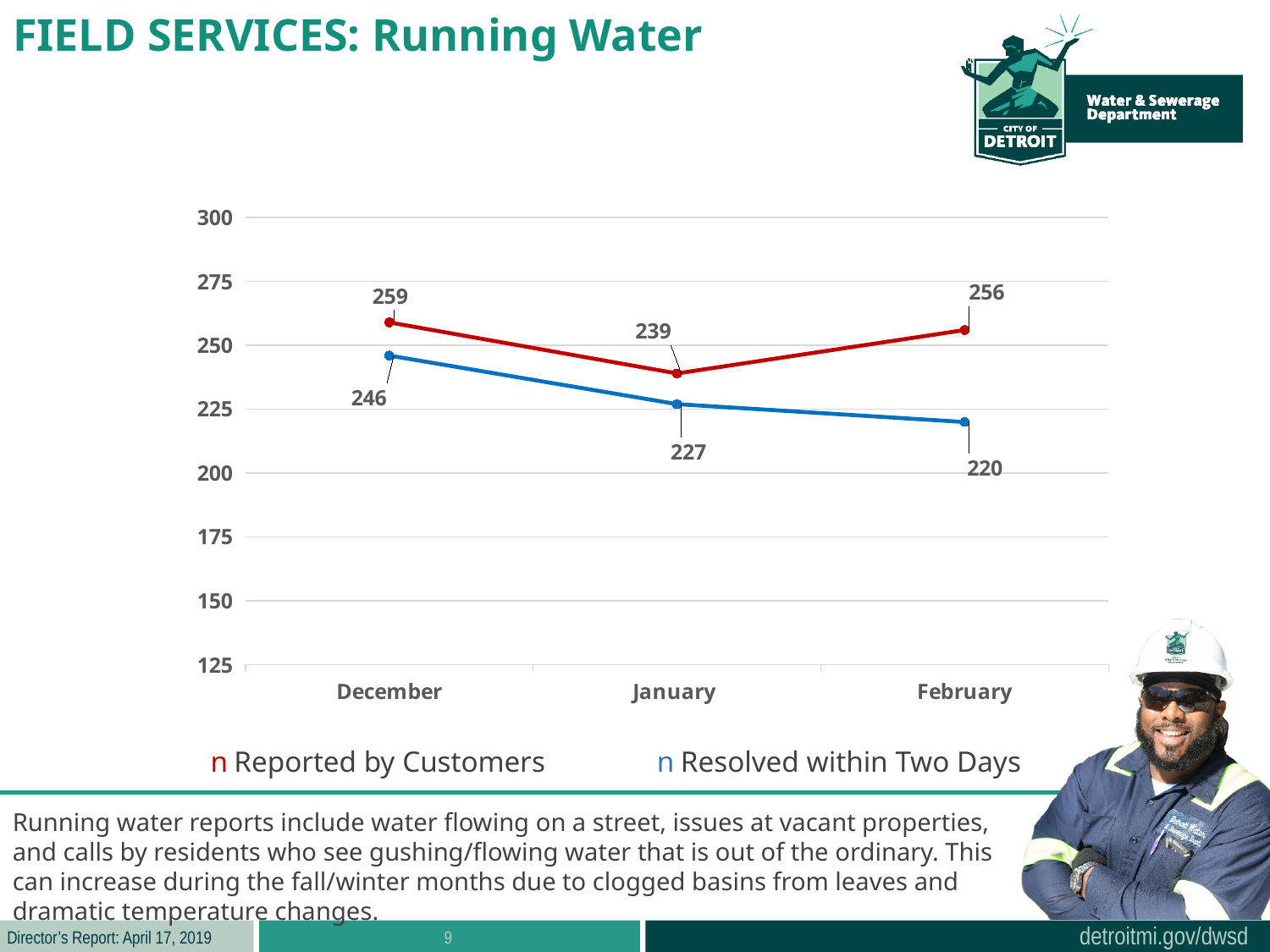
What is the value for Reported by Customers in December? 259 What kind of chart is shown on the slide? Line chart What colour is the line for Reported by Customers? Red How many months are shown on the x axis? 3 What is the difference between Reported by Customers and Resolved within Two Days in February? 36 What is the value for Resolved within Two Days in January? 227 Does the Resolved within Two Days series rise or fall from December to February? Fall In which month is the Reported by Customers value lowest? January Which is larger in December: Reported by Customers or Resolved within Two Days? Reported by Customers How many series does the legend list? 2 What is the value for Reported by Customers in February? 256 In which month is the Resolved within Two Days value highest? December